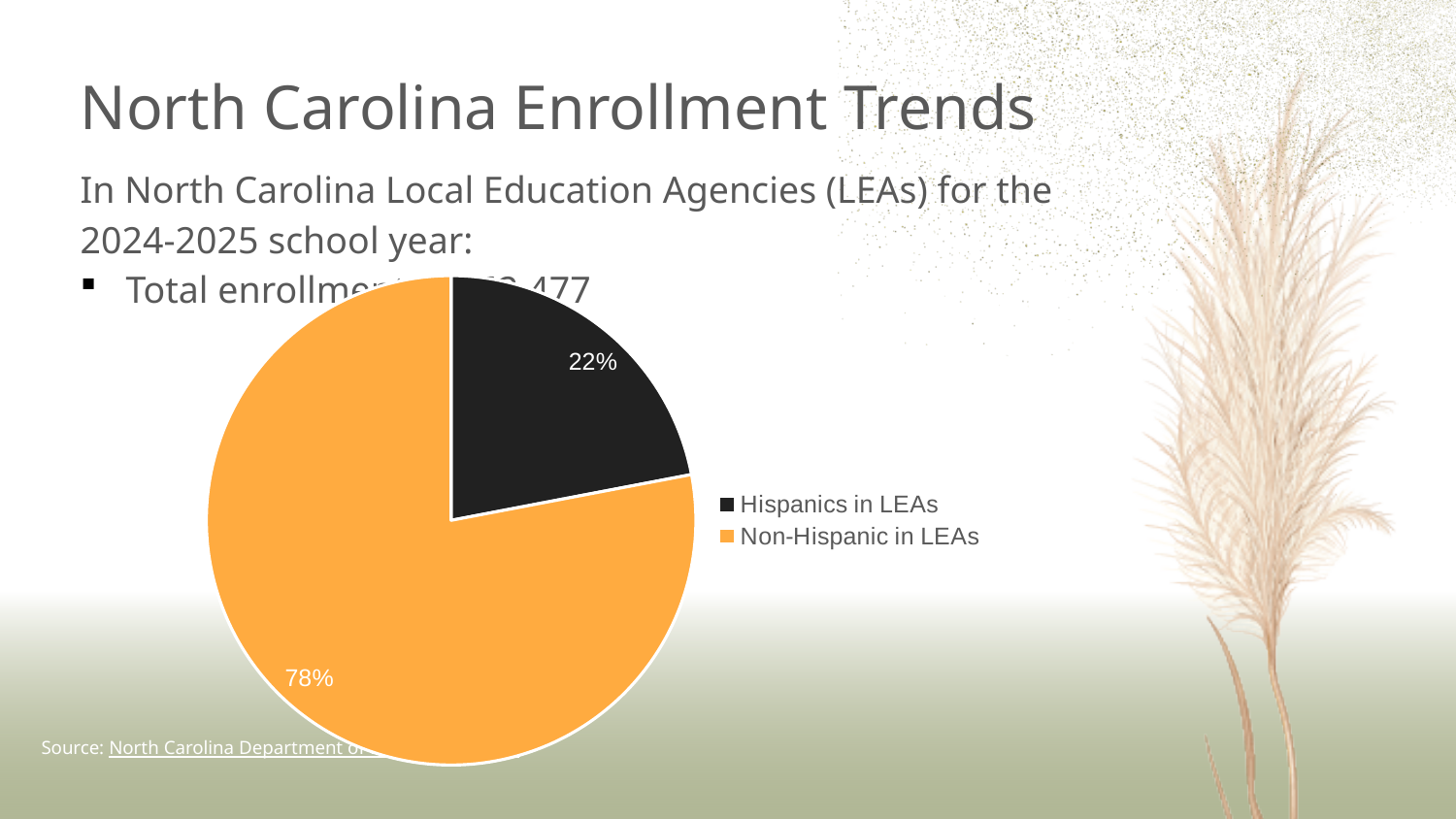
What colour is the Hispanics in LEAs slice? black What is the difference in percentage points between the Non-Hispanic in LEAs slice and the Hispanics in LEAs slice? 56 What share of the pie does the Hispanics in LEAs slice represent? 22% What colour is the Non-Hispanic in LEAs slice? orange What kind of chart is shown on the slide? pie chart How many slices does the pie chart have? 2 Which is larger, the Hispanics in LEAs slice or the Non-Hispanic in LEAs slice? Non-Hispanic in LEAs Which slice of the pie is the smallest? Hispanics in LEAs How many entries does the legend list? 2 Which slice of the pie is the largest? Non-Hispanic in LEAs What percentage of the pie is labelled for Hispanics in LEAs? 22% What percentage of the pie is labelled for Non-Hispanic in LEAs? 78%